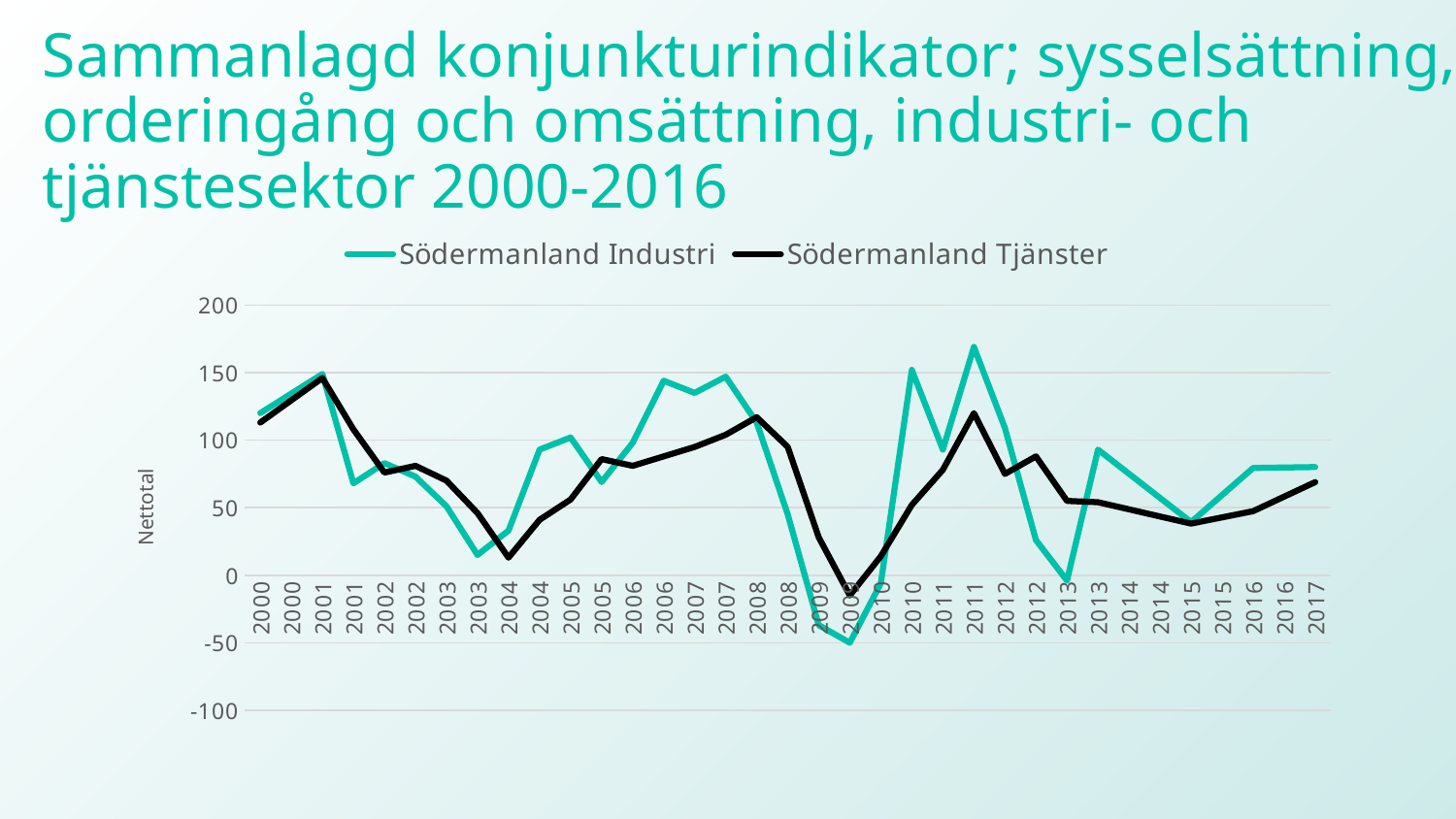
Is the lowest value of Södermanland Industri in 2009 greater or less than 0? less Which series reaches the highest value anywhere on the chart? Södermanland Industri What are the two series named in the legend? Södermanland Industri and Södermanland Tjänster Is the peak value of Södermanland Industri in 2011 greater or less than 150? greater What is the label on the vertical axis? Nettotal Between 2001 and 2004, does the Södermanland Tjänster line rise or fall? fall Is the value of Södermanland Tjänster at the first 2001 point greater or less than 100? greater At the first 2013 point, which series has the larger value, Södermanland Industri or Södermanland Tjänster? Södermanland Tjänster What kind of chart is shown on the slide? line chart Which series reaches the lowest value anywhere on the chart? Södermanland Industri How many distinct years are labelled on the x axis? 18 How many series does the legend list? 2